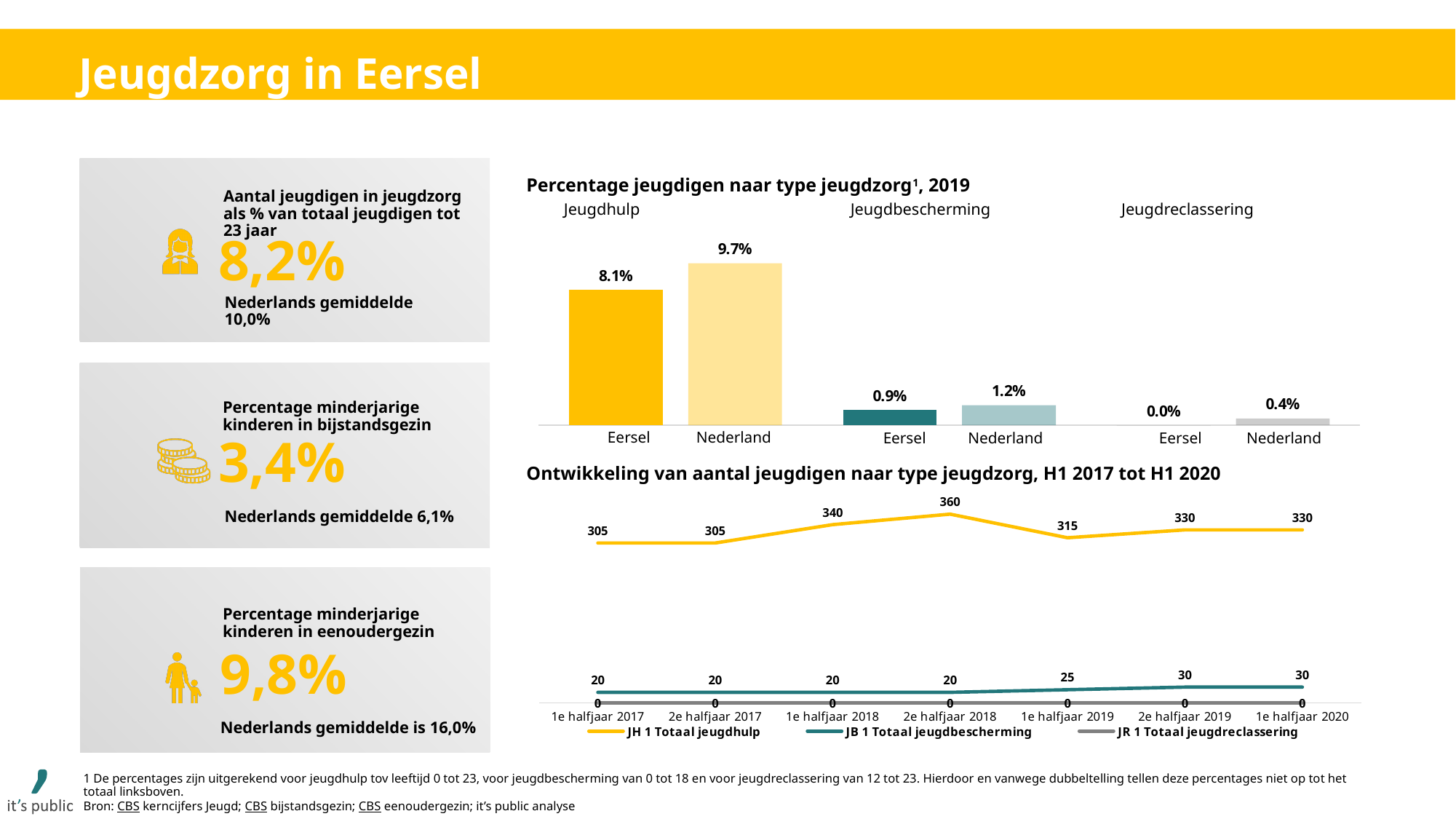
In the chart 'Percentage jeugdigen naar type jeugdzorg, 2019', what is the Jeugdbescherming value for Nederland? 1.2% In the chart 'Ontwikkeling van aantal jeugdigen naar type jeugdzorg, H1 2017 tot H1 2020', how many time points are shown on the x axis? 7 In the chart 'Percentage jeugdigen naar type jeugdzorg, 2019', is the Jeugdbescherming value for Eersel larger or smaller than that for Nederland? smaller In the chart 'Percentage jeugdigen naar type jeugdzorg, 2019', what is the difference between the Jeugdhulp values for Nederland and Eersel? 1.6% In the chart 'Percentage jeugdigen naar type jeugdzorg, 2019', which bar is the highest? Nederland (Jeugdhulp), 9.7% In the chart 'Ontwikkeling van aantal jeugdigen naar type jeugdzorg, H1 2017 tot H1 2020', what is the value of JH 1 Totaal jeugdhulp in 2e halfjaar 2018? 360 In the chart 'Percentage jeugdigen naar type jeugdzorg, 2019', what is the Jeugdreclassering value for Eersel? 0.0% In the chart 'Ontwikkeling van aantal jeugdigen naar type jeugdzorg, H1 2017 tot H1 2020', what is the difference between the JH 1 Totaal jeugdhulp values in 2e halfjaar 2018 and 1e halfjaar 2019? 45 In the chart 'Percentage jeugdigen naar type jeugdzorg, 2019', what is the Jeugdhulp value for Eersel? 8.1% In the chart 'Ontwikkeling van aantal jeugdigen naar type jeugdzorg, H1 2017 tot H1 2020', how many series does the legend list? 3 What type of chart is 'Percentage jeugdigen naar type jeugdzorg, 2019'? bar chart In the chart 'Ontwikkeling van aantal jeugdigen naar type jeugdzorg, H1 2017 tot H1 2020', what is the value of JB 1 Totaal jeugdbescherming in 1e halfjaar 2019? 25